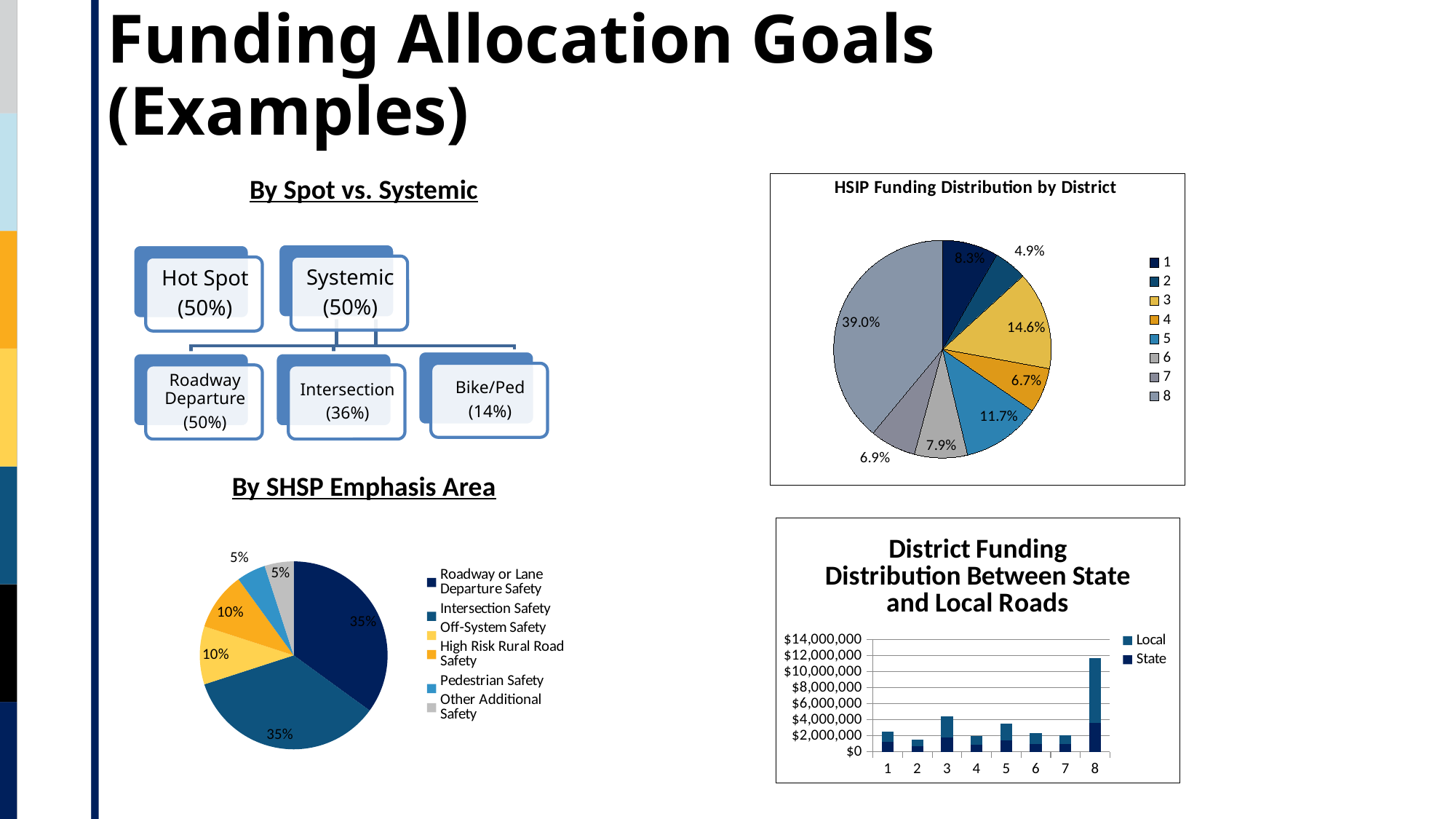
In the HSIP Funding Distribution by District pie chart, what share does district 3 have? 14.6% In the HSIP Funding Distribution by District pie chart, what is the difference between the shares of district 5 and district 4? 5.0% In the By SHSP Emphasis Area pie chart, how many categories does the legend list? 6 In the HSIP Funding Distribution by District pie chart, which district has the largest share? 8 In the HSIP Funding Distribution by District pie chart, which district has the smallest share? 2 In the District Funding Distribution Between State and Local Roads chart, is the total for district 8 greater or less than $10,000,000? greater What kind of chart is the District Funding Distribution Between State and Local Roads chart? bar chart In the HSIP Funding Distribution by District pie chart, what share does district 8 have? 39.0% In the HSIP Funding Distribution by District pie chart, how many districts does the legend list? 8 In the By SHSP Emphasis Area pie chart, which is larger, Intersection Safety or High Risk Rural Road Safety? Intersection Safety In the District Funding Distribution Between State and Local Roads chart, how many series does the legend list? 2 In the By SHSP Emphasis Area pie chart, what share is Pedestrian Safety? 5%